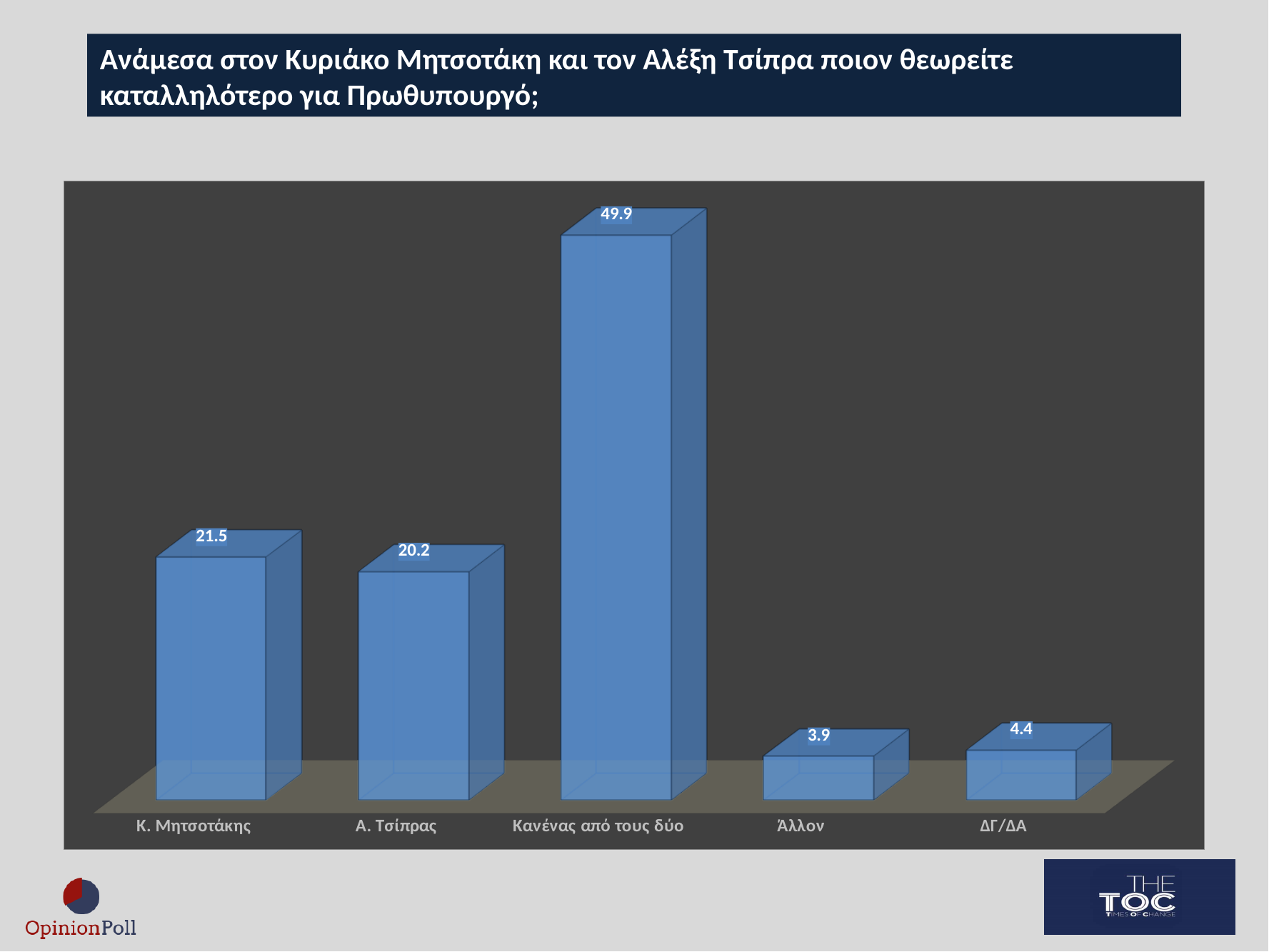
What is the difference between the values for Κανένας από τους δύο and Κ. Μητσοτάκης? 28.4 What is the difference between the values for Κ. Μητσοτάκης and Α. Τσίπρας? 1.3 What is the value for Άλλον? 3.9 What is the value for Κανένας από τους δύο? 49.9 What is the value for Α. Τσίπρας? 20.2 How many categories are shown in the chart? 5 What is the value for ΔΓ/ΔΑ? 4.4 Which category has the highest value? Κανένας από τους δύο What kind of chart is shown on the slide? Bar chart Which category has the lowest value? Άλλον What is the value for Κ. Μητσοτάκης? 21.5 Which is larger, the value for ΔΓ/ΔΑ or the value for Άλλον? ΔΓ/ΔΑ